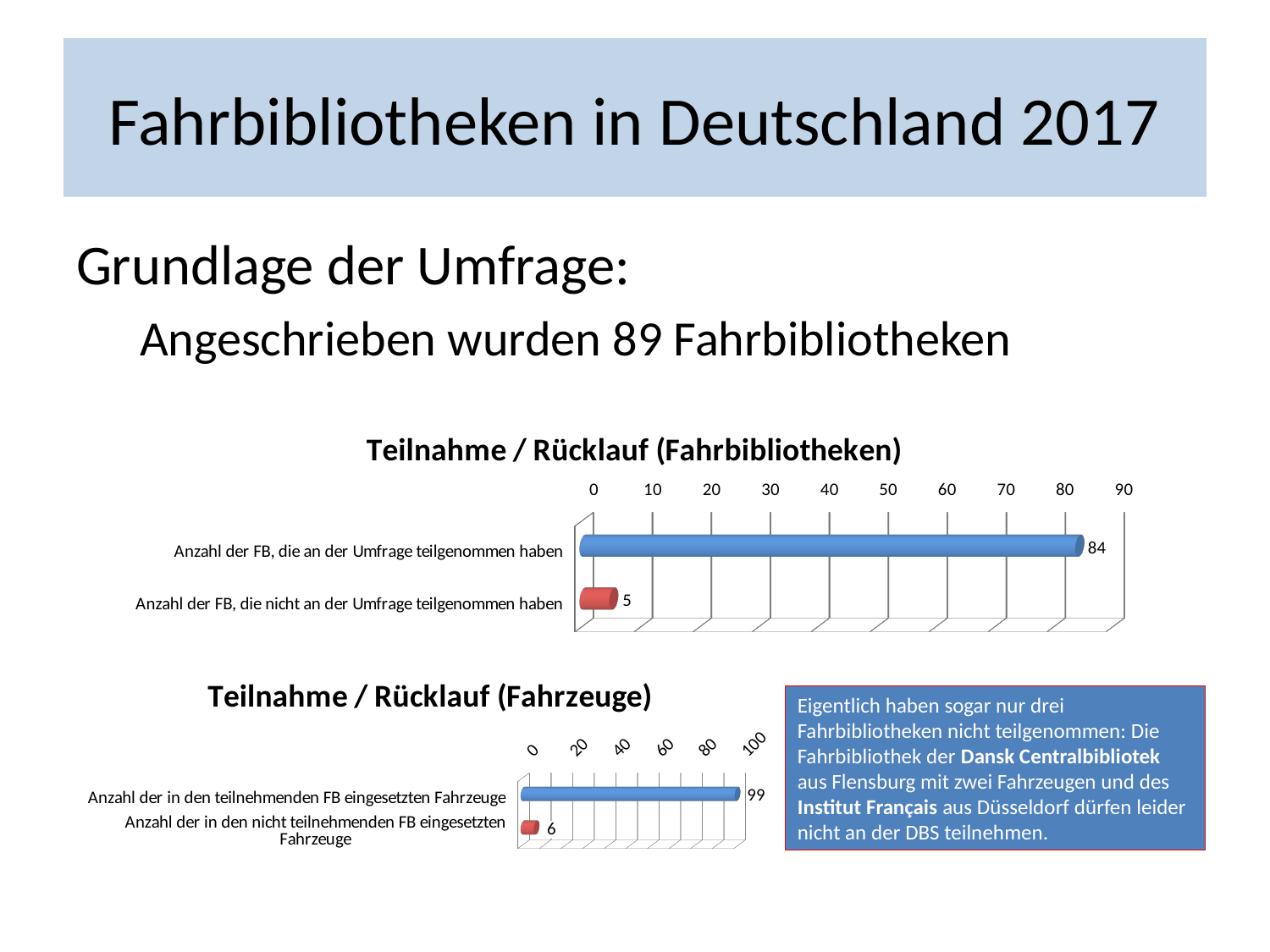
In the 'Teilnahme / Rücklauf (Fahrzeuge)' chart, what is the value for 'Anzahl der in den teilnehmenden FB eingesetzten Fahrzeuge'? 99 In the 'Teilnahme / Rücklauf (Fahrbibliotheken)' chart, what is the value for 'Anzahl der FB, die an der Umfrage teilgenommen haben'? 84 In the 'Teilnahme / Rücklauf (Fahrzeuge)' chart, is the value for 'Anzahl der in den teilnehmenden FB eingesetzten Fahrzeuge' greater or less than 80? greater In the 'Teilnahme / Rücklauf (Fahrbibliotheken)' chart, what is the difference between the two bars? 79 In the 'Teilnahme / Rücklauf (Fahrzeuge)' chart, what is the value for 'Anzahl der in den nicht teilnehmenden FB eingesetzten Fahrzeuge'? 6 In the 'Teilnahme / Rücklauf (Fahrbibliotheken)' chart, how many categories are shown? 2 In the 'Teilnahme / Rücklauf (Fahrzeuge)' chart, which category has the lowest value? Anzahl der in den nicht teilnehmenden FB eingesetzten Fahrzeuge In the 'Teilnahme / Rücklauf (Fahrzeuge)' chart, what is the difference between the two bars? 93 In the 'Teilnahme / Rücklauf (Fahrbibliotheken)' chart, which category has the highest value? Anzahl der FB, die an der Umfrage teilgenommen haben What is the title of the upper chart on the slide? Teilnahme / Rücklauf (Fahrbibliotheken) What kind of chart is 'Teilnahme / Rücklauf (Fahrbibliotheken)'? Bar chart In the 'Teilnahme / Rücklauf (Fahrbibliotheken)' chart, what is the value for 'Anzahl der FB, die nicht an der Umfrage teilgenommen haben'? 5